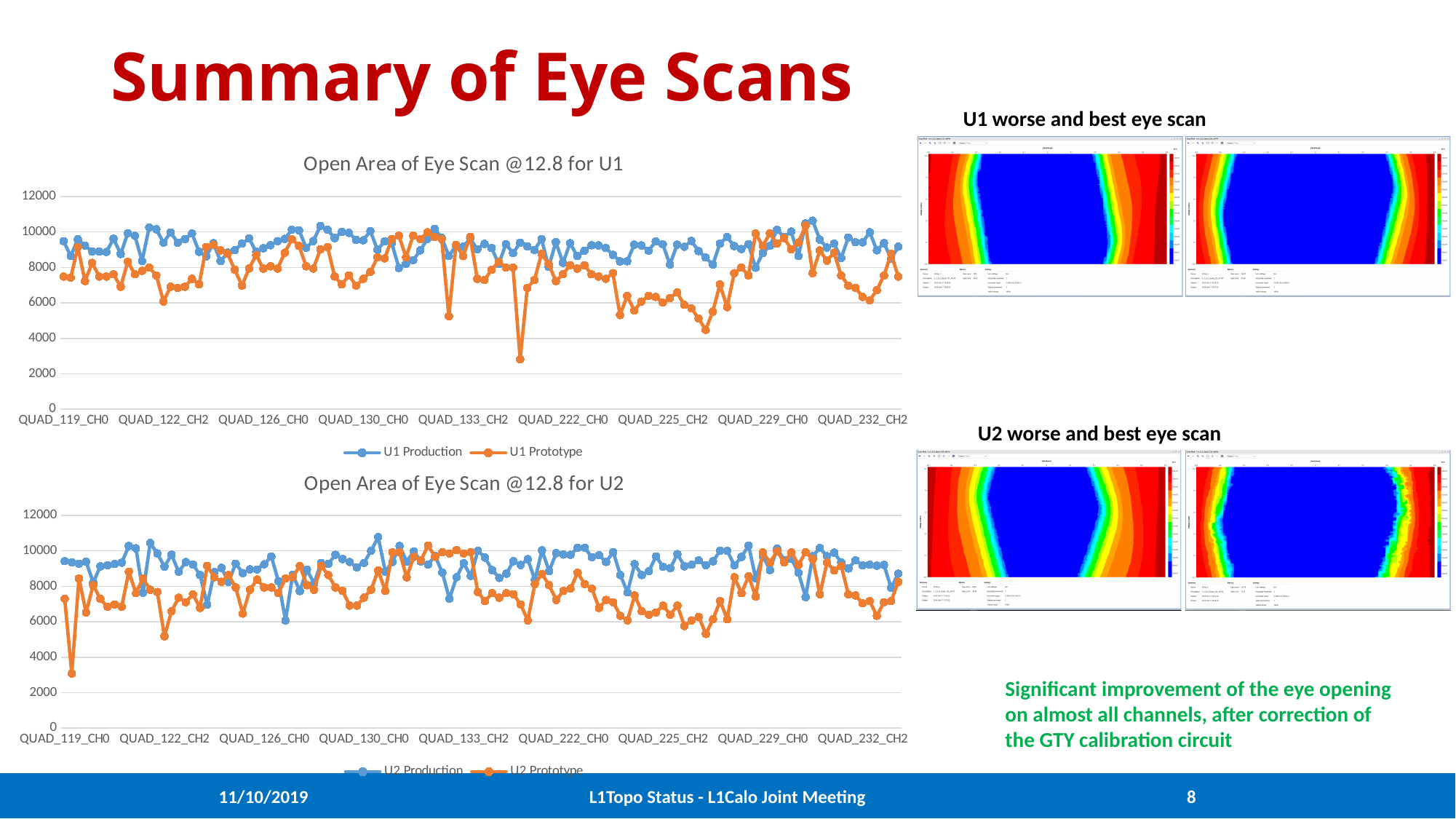
What is the highest tick value shown on the y axis of the bottom chart (U2)? 12000 How many category labels are printed on the x axis of the top chart (U1)? 9 What is the title of the top chart? Open Area of Eye Scan @12.8 for U1 In the top chart (U1), is the lowest point of the U1 Prototype series greater or less than 4000? less What is the last category label on the x axis of the top chart (U1)? QUAD_232_CH2 What are the two series named in the legend of the bottom chart (U2)? U2 Production and U2 Prototype In the bottom chart (U2), which series is generally higher across the channels, U2 Production or U2 Prototype? U2 Production What type of chart is the top chart titled 'Open Area of Eye Scan @12.8 for U1'? line chart How many series does the legend of the top chart (U1) list? 2 In the top chart (U1), which series is generally higher across the channels, U1 Production or U1 Prototype? U1 Production What type of chart is the bottom chart titled 'Open Area of Eye Scan @12.8 for U2'? line chart What is the first category label on the x axis of the bottom chart (U2)? QUAD_119_CH0